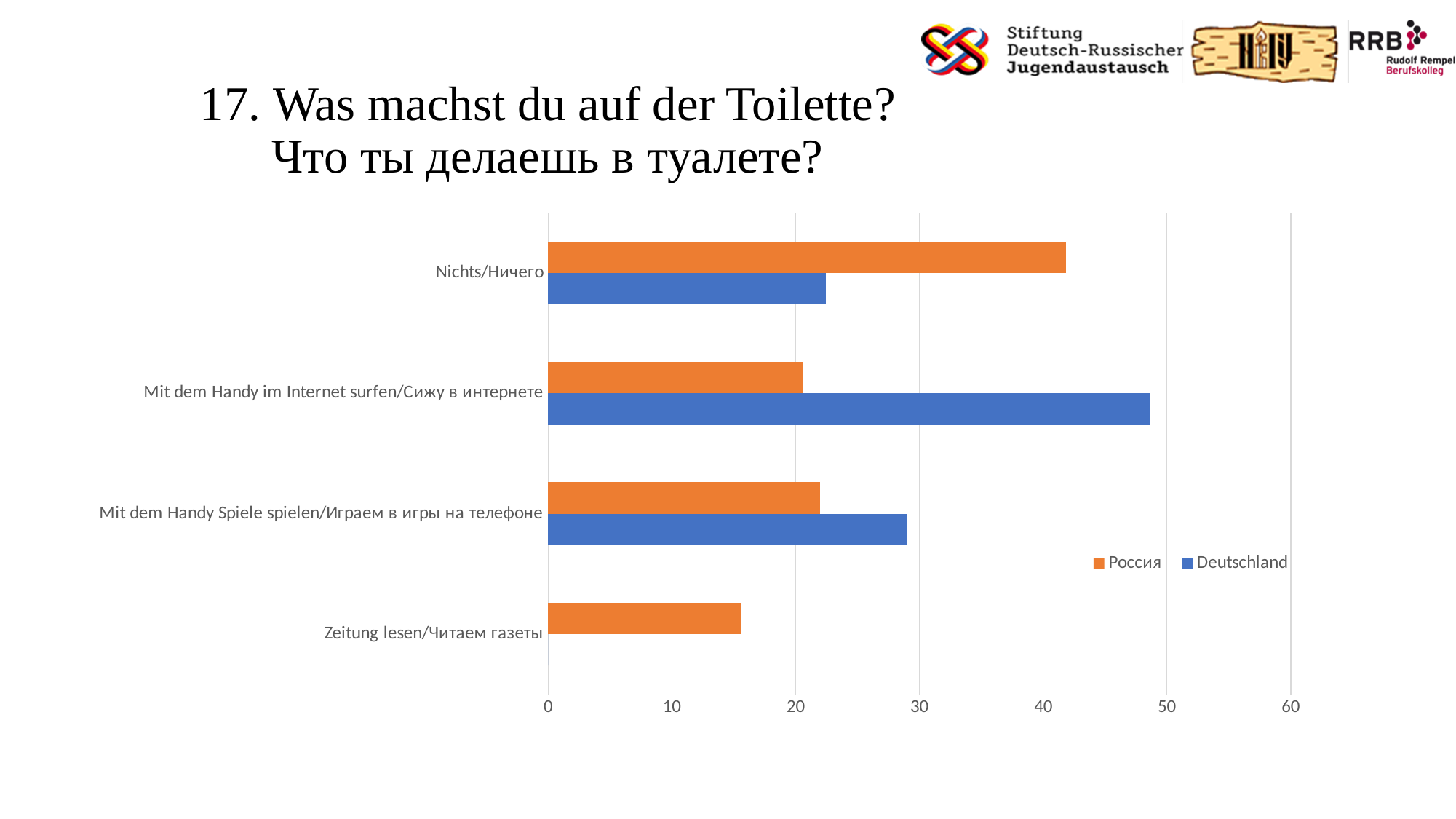
Is the Deutschland value for Mit dem Handy im Internet surfen/Сижу в интернете greater or less than 40? greater How many series does the legend list? 2 Which category has the highest value for Россия? Nichts/Ничего Is the Россия value for Zeitung lesen/Читаем газеты greater or less than 20? less For Nichts/Ничего, which series has the larger value, Россия or Deutschland? Россия For Mit dem Handy im Internet surfen/Сижу в интернете, which series has the larger value, Россия or Deutschland? Deutschland What kind of chart is shown on the slide? bar chart For Mit dem Handy Spiele spielen/Играем в игры на телефоне, which series has the larger value, Россия or Deutschland? Deutschland Which category has the lowest value for Россия? Zeitung lesen/Читаем газеты Which category has the highest value for Deutschland? Mit dem Handy im Internet surfen/Сижу в интернете Which colour represents the Deutschland series in the chart? blue How many categories are shown on the vertical axis of the chart? 4